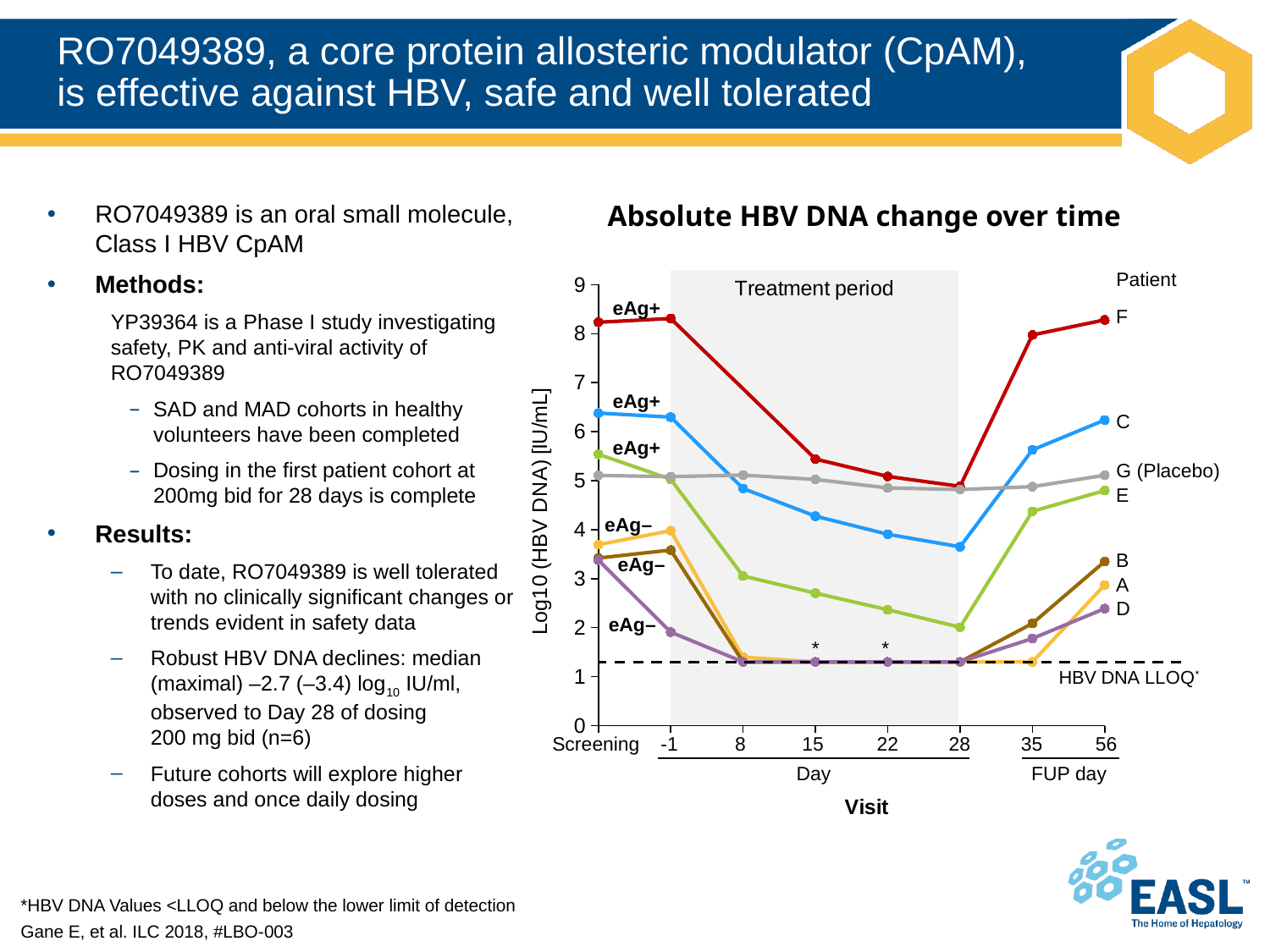
What kind of chart is shown on the slide? Line chart How many visit time points are shown along the x axis? 8 Is the value for Patient D at Screening greater or less than 4? less Is the value for Patient C at Day 28 greater or less than 4? less Is the value for Patient F at Screening greater or less than 8? greater How many patients (series) are plotted in the chart? 7 Does the value for Patient F rise or fall from Day -1 to Day 28? Fall Which patient has the highest HBV DNA value at Screening? F At FUP day 56, which patient has the larger value, C or E? C What is the title of the chart? Absolute HBV DNA change over time Which patient has the highest HBV DNA value at FUP day 56? F